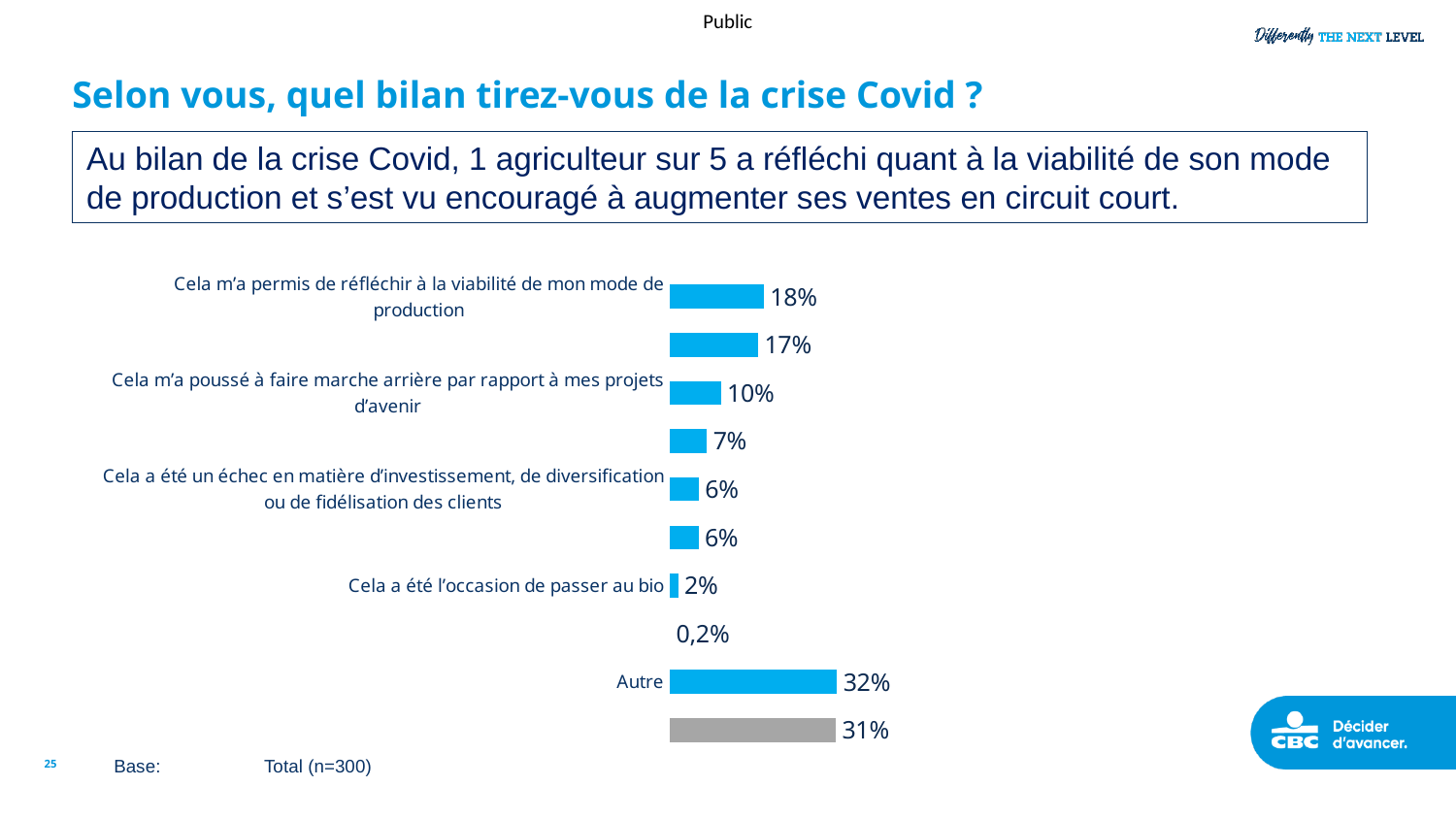
What is the difference between the value for "Cela m’a permis de réfléchir à la viabilité de mon mode de production" and the value for "Cela m’a poussé à faire marche arrière par rapport à mes projets d’avenir"? 8 percentage points Which labelled category has the highest value? Autre How many bars are plotted on the chart? 10 What is the value for "Cela a été un échec en matière d’investissement, de diversification ou de fidélisation des clients"? 6% What colour is the bottom bar (31%) on the chart? grey What is the smallest value shown on the chart? 0,2% What is the value for "Cela a été l’occasion de passer au bio"? 2% What is the value for "Cela m’a permis de réfléchir à la viabilité de mon mode de production"? 18% What kind of chart is shown on the slide? bar chart What is the value for "Cela m’a poussé à faire marche arrière par rapport à mes projets d’avenir"? 10% What is the value for "Autre"? 32% Which is larger: the value for "Autre" or the value for "Cela a été l’occasion de passer au bio"? Autre